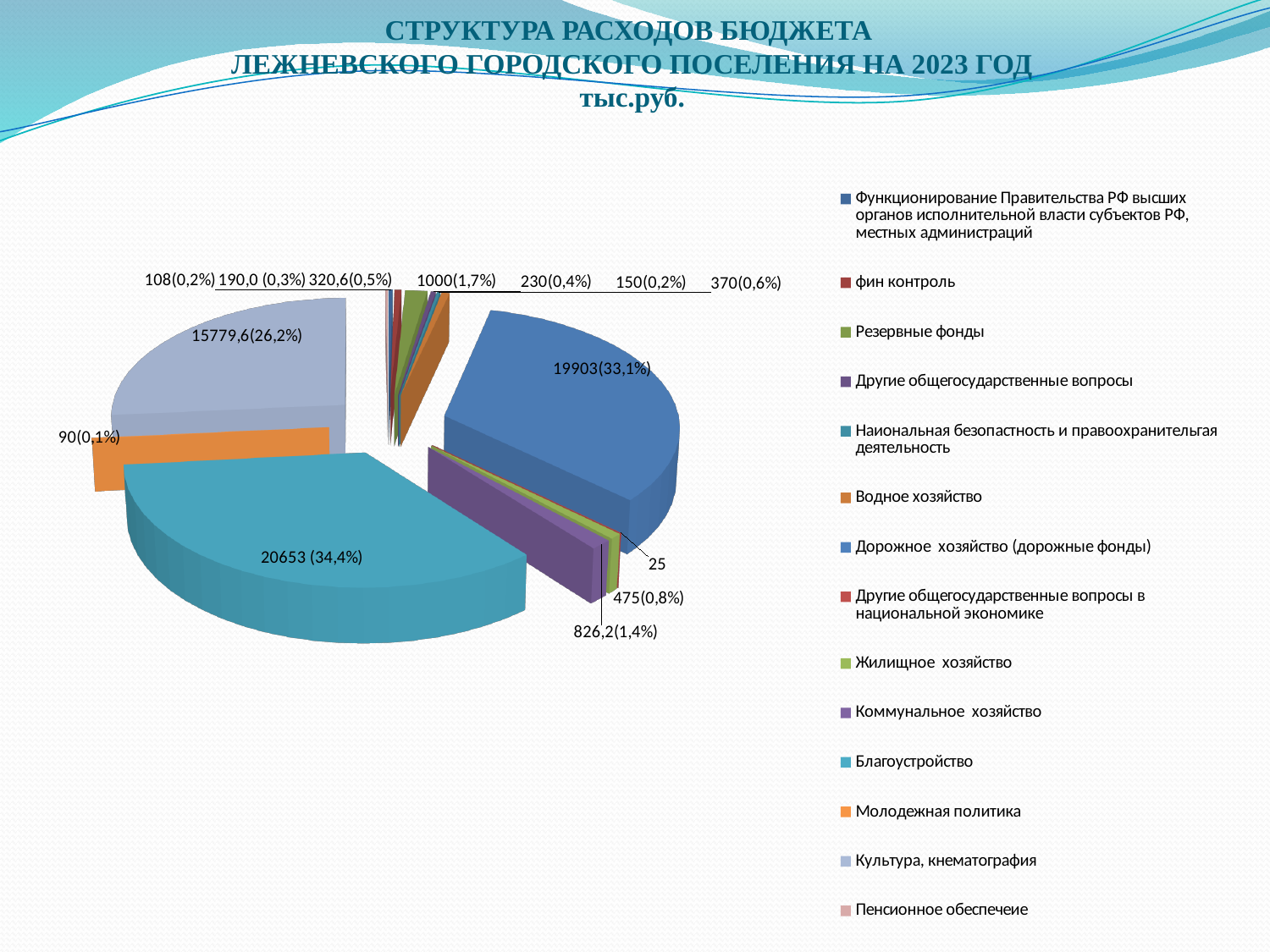
What is the value labelled for Культура, кнематография? 15779,6(26,2%) How many categories does the legend of the pie chart list? 14 What share of the pie does Дорожное хозяйство (дорожные фонды) account for? 33,1% What value is labelled on the largest slice of the pie chart? 20653 (34,4%) Which category has the largest slice of the pie chart? Благоустройство What is the value labelled for Коммунальное хозяйство? 826,2(1,4%) What is the value labelled for Дорожное хозяйство (дорожные фонды)? 19903(33,1%) What share of the pie does Благоустройство account for? 34,4% Which is larger, the slice for Благоустройство or the slice for Дорожное хозяйство (дорожные фонды)? Благоустройство What kind of chart is shown on the slide? pie chart In what units are the values on the chart given, according to the slide title? тыс.руб. What is the difference between the value for Благоустройство (20653) and the value for Дорожное хозяйство (19903)? 750